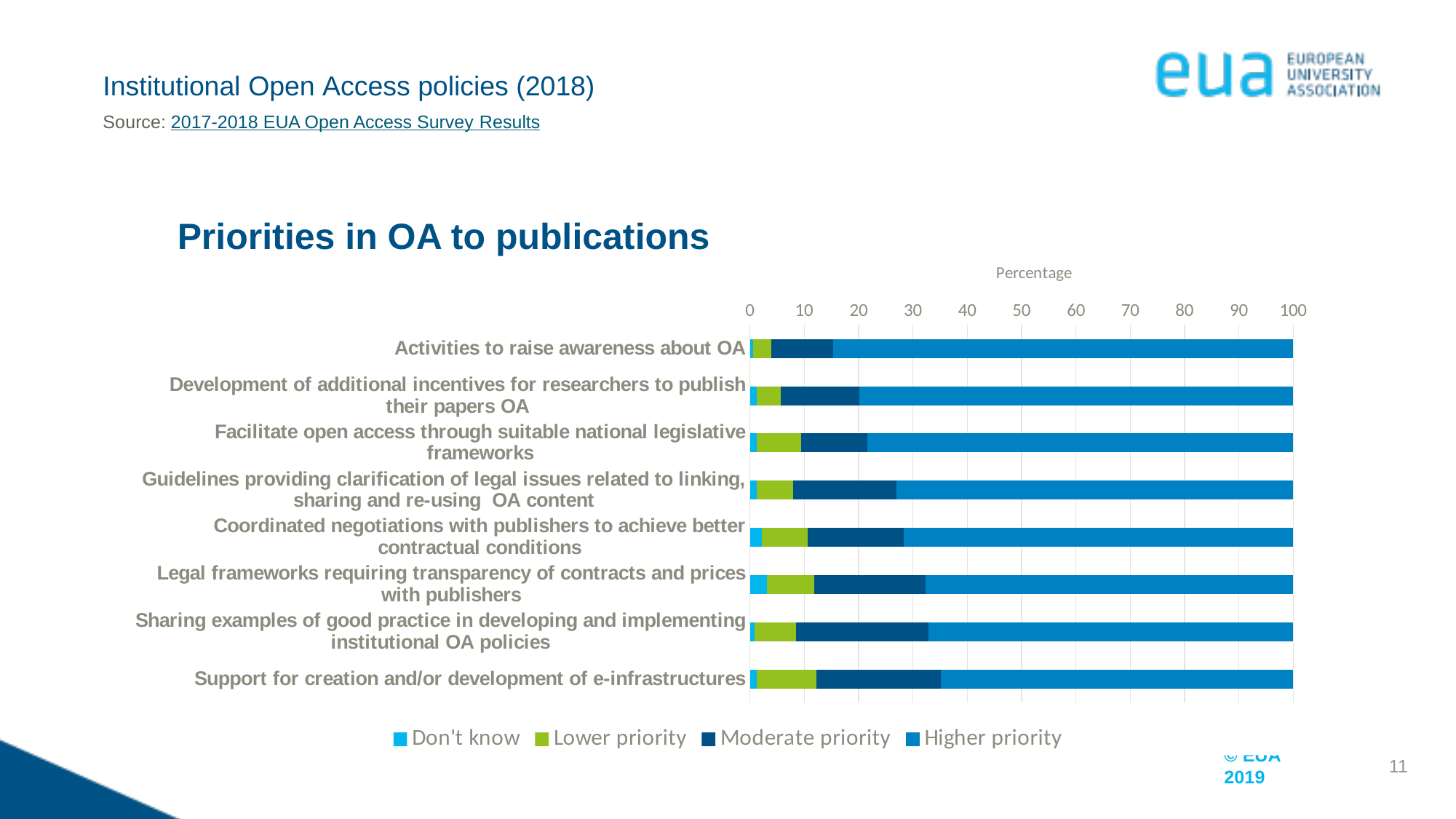
Is the 'Higher priority' value for 'Support for creation and/or development of e-infrastructures' greater or less than 70? less Is the 'Lower priority' value for 'Activities to raise awareness about OA' greater or less than 10? less Which category has the largest 'Higher priority' share? Activities to raise awareness about OA How many series does the legend list? 4 Which category has the largest 'Don't know' share? Legal frameworks requiring transparency of contracts and prices with publishers What is the label on the horizontal axis of the chart? Percentage What is the total of the stacked bar for 'Activities to raise awareness about OA'? 100 Is the 'Higher priority' value for 'Activities to raise awareness about OA' greater or less than 80? greater What is the title of the chart? Priorities in OA to publications Which is larger, the 'Higher priority' value for 'Activities to raise awareness about OA' or for 'Support for creation and/or development of e-infrastructures'? Activities to raise awareness about OA How many categories (priority items) are plotted in the chart? 8 What kind of chart is shown on the slide? Stacked bar chart